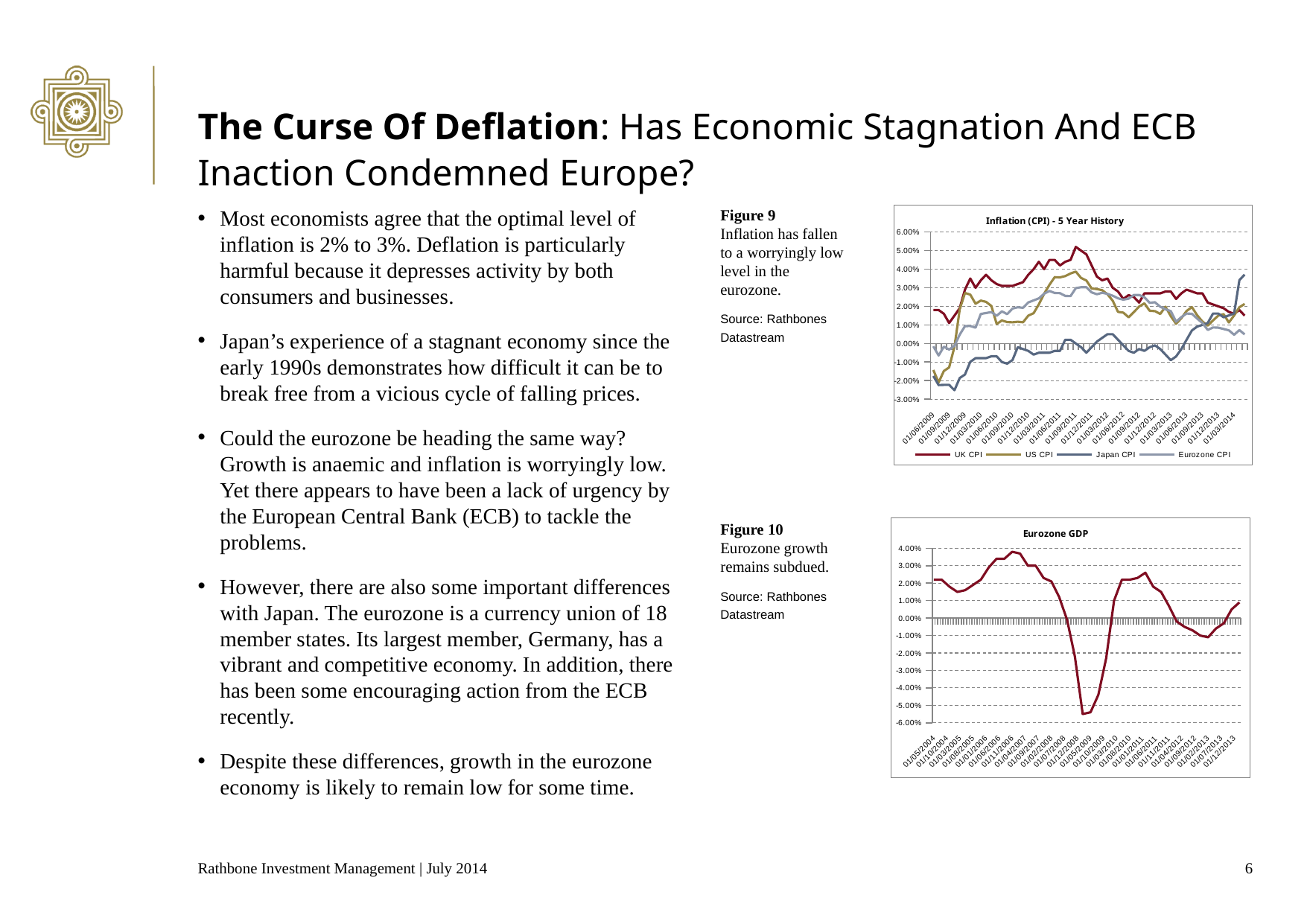
In the 'Eurozone GDP' chart, does the value rise or fall between 01/04/2007 and 01/05/2009? fall In the 'Inflation (CPI) - 5 Year History' chart, does UK CPI rise or fall between 01/12/2011 and 01/03/2014? fall Which series are listed in the legend of the 'Inflation (CPI) - 5 Year History' chart? UK CPI, US CPI, Japan CPI, Eurozone CPI In the 'Inflation (CPI) - 5 Year History' chart, is the final value of Japan CPI in 2014 greater or less than 3.00%? greater What kind of chart is Figure 10, 'Eurozone GDP'? Line chart What kind of chart is Figure 9, 'Inflation (CPI) - 5 Year History'? Line chart In the 'Inflation (CPI) - 5 Year History' chart, which series reaches the highest value over the period? UK CPI In the 'Inflation (CPI) - 5 Year History' chart, is the value of Japan CPI at 01/09/2009 greater or less than 0.00%? less In the 'Eurozone GDP' chart, is the highest value greater or less than 3.00%? greater How many series does the legend of the 'Inflation (CPI) - 5 Year History' chart list? 4